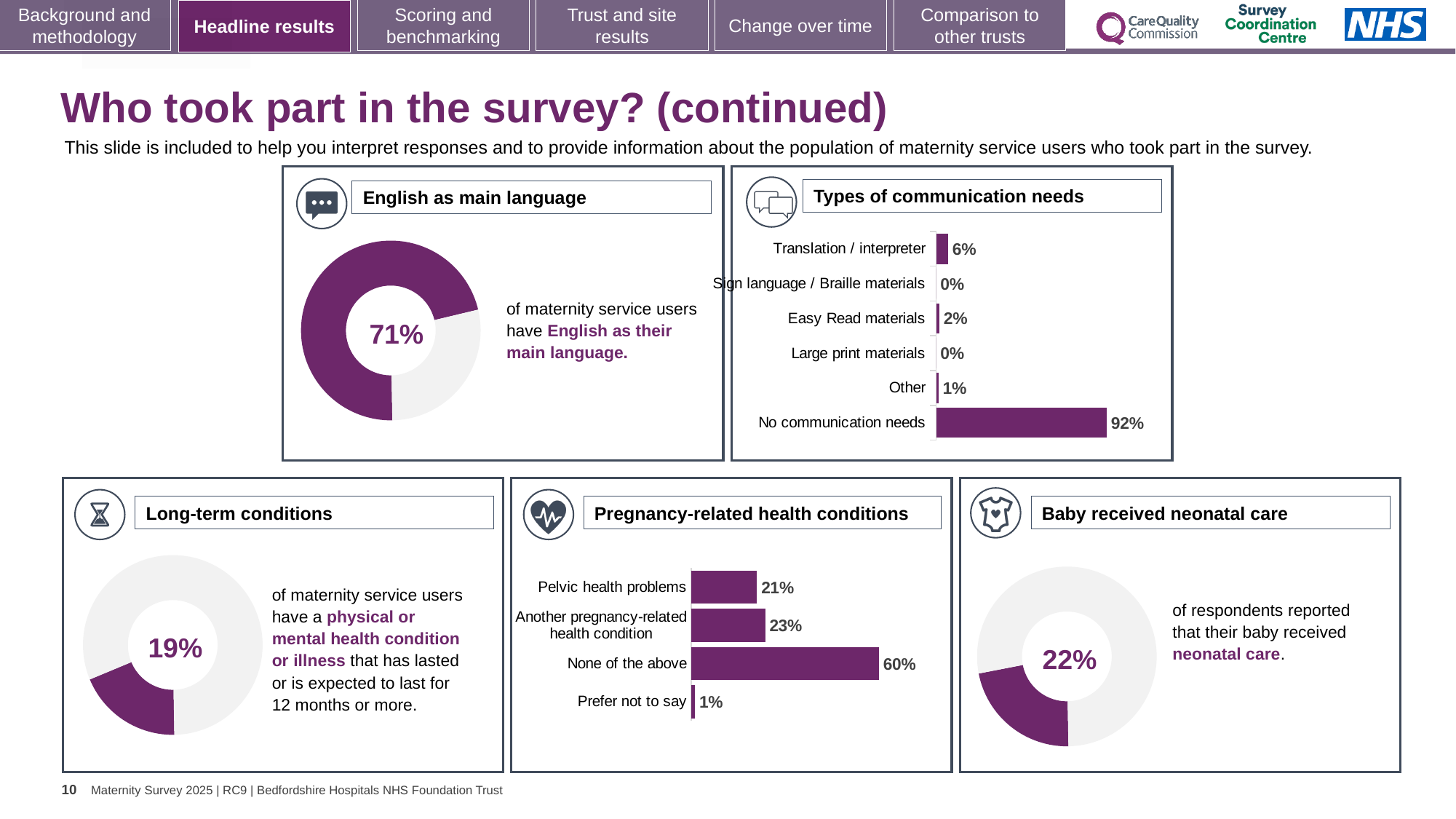
In the 'Long-term conditions' chart, what percentage of maternity service users have a physical or mental health condition or illness? 19% In the 'Types of communication needs' chart, what is the difference between No communication needs and Translation / interpreter? 86% In the 'Pregnancy-related health conditions' chart, what percentage is shown for Pelvic health problems? 21% In the 'Types of communication needs' chart, how many categories are shown? 6 In the 'Pregnancy-related health conditions' chart, which category has the lowest value? Prefer not to say In the 'Pregnancy-related health conditions' chart, what is the difference between None of the above and Another pregnancy-related health condition? 37% In the 'Types of communication needs' chart, which category has the highest value? No communication needs In the 'Pregnancy-related health conditions' chart, which is larger: Pelvic health problems or Another pregnancy-related health condition? Another pregnancy-related health condition In the 'Types of communication needs' chart, what percentage is shown for Translation / interpreter? 6% In the 'Baby received neonatal care' chart, what percentage of respondents reported that their baby received neonatal care? 22% In the 'English as main language' chart, what percentage of maternity service users have English as their main language? 71% What kind of chart is used for 'Types of communication needs'? Bar chart